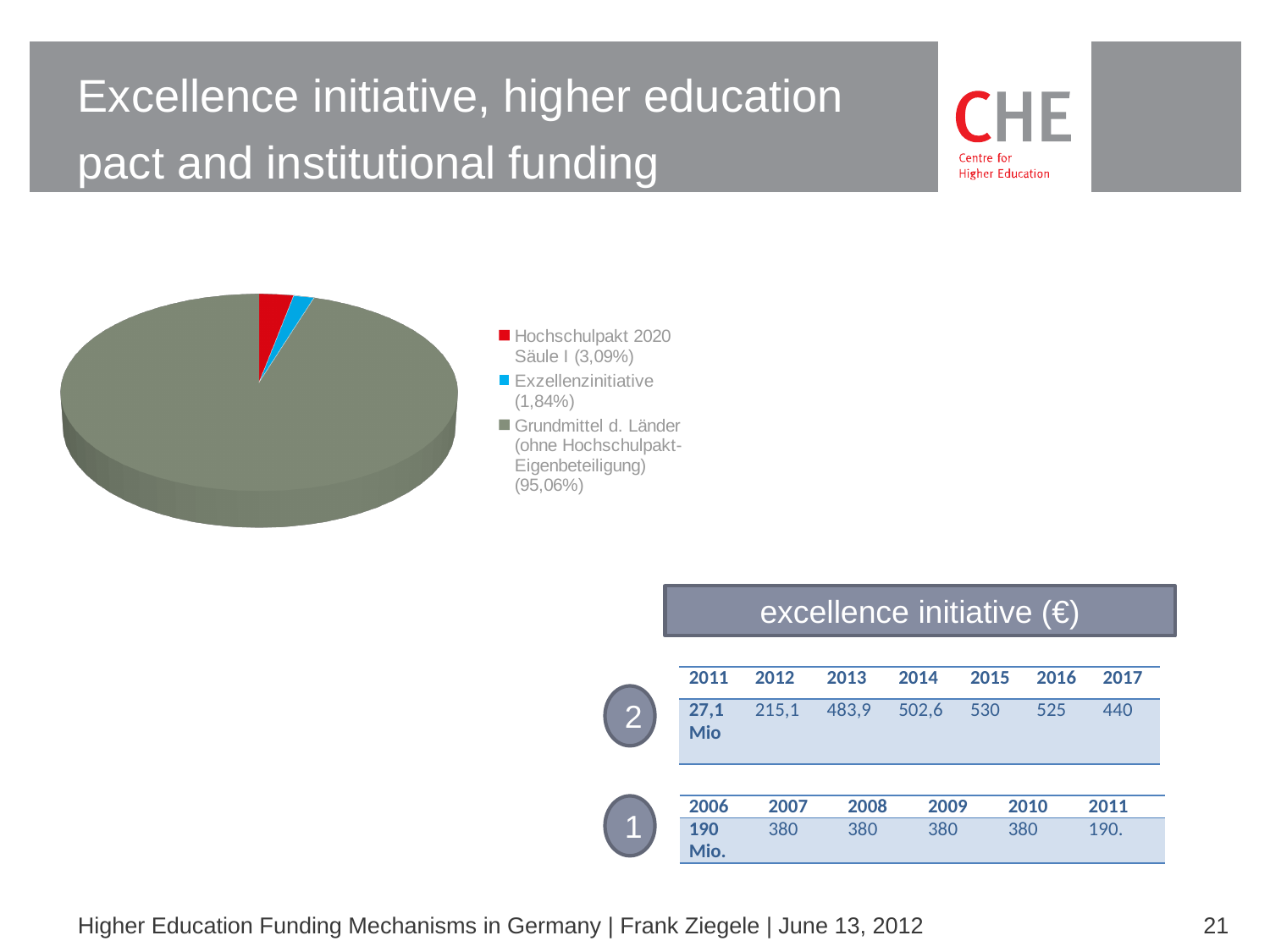
What share of the pie does Exzellenzinitiative represent? 1,84% What share of the pie does Grundmittel d. Länder (ohne Hochschulpakt-Eigenbeteiligung) represent? 95,06% By how many percentage points does Hochschulpakt 2020 Säule I exceed Exzellenzinitiative in the pie chart? 1,25% What kind of chart is shown on the slide? pie chart Which slice of the pie chart is the largest? Grundmittel d. Länder (ohne Hochschulpakt-Eigenbeteiligung) What share of the pie does Hochschulpakt 2020 Säule I represent? 3,09% Which slice of the pie chart is the smallest? Exzellenzinitiative How many slices does the pie chart have? 3 What is the difference between the Grundmittel d. Länder share and the Hochschulpakt 2020 Säule I share in the pie chart? 91,97% What colour is the Hochschulpakt 2020 Säule I slice in the pie chart? red What colour is the Exzellenzinitiative slice in the pie chart? blue Which is larger in the pie chart, Hochschulpakt 2020 Säule I or Exzellenzinitiative? Hochschulpakt 2020 Säule I